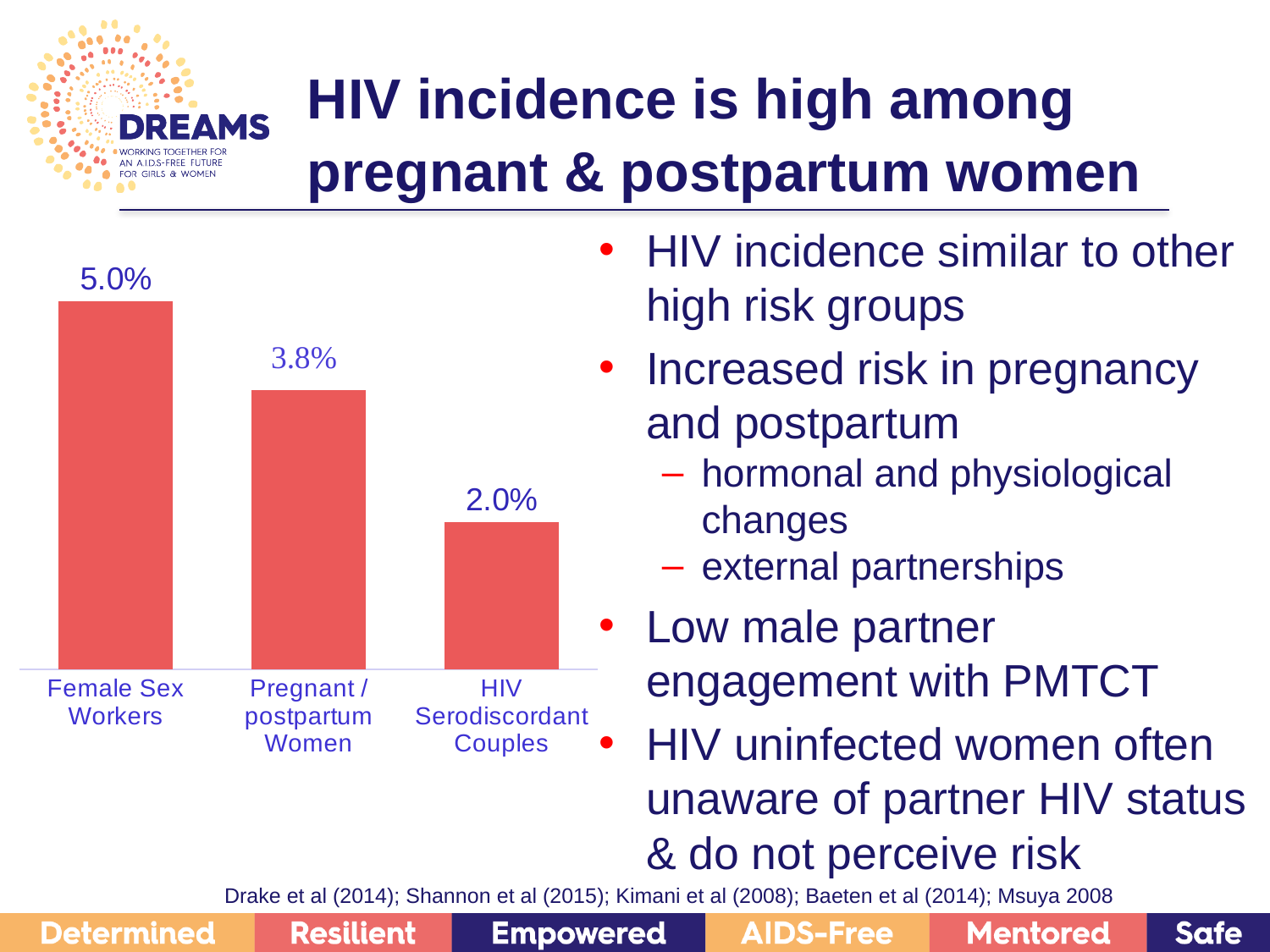
Which category has the lowest value in the bar chart? HIV Serodiscordant Couples What is the difference between the values for Pregnant / postpartum Women and HIV Serodiscordant Couples? 1.8% How many categories are shown in the bar chart? 3 What is the HIV incidence value shown for Female Sex Workers? 5.0% What is the HIV incidence value shown for Pregnant / postpartum Women? 3.8% What kind of chart is shown on the slide? Bar chart What is the difference between the values for Female Sex Workers and Pregnant / postpartum Women? 1.2% What is the HIV incidence value shown for HIV Serodiscordant Couples? 2.0% Which category has the highest value in the bar chart? Female Sex Workers What colour are the bars in the chart? Red Do the values rise or fall from left to right across the categories? Fall Which is larger, the value for Pregnant / postpartum Women or the value for HIV Serodiscordant Couples? Pregnant / postpartum Women